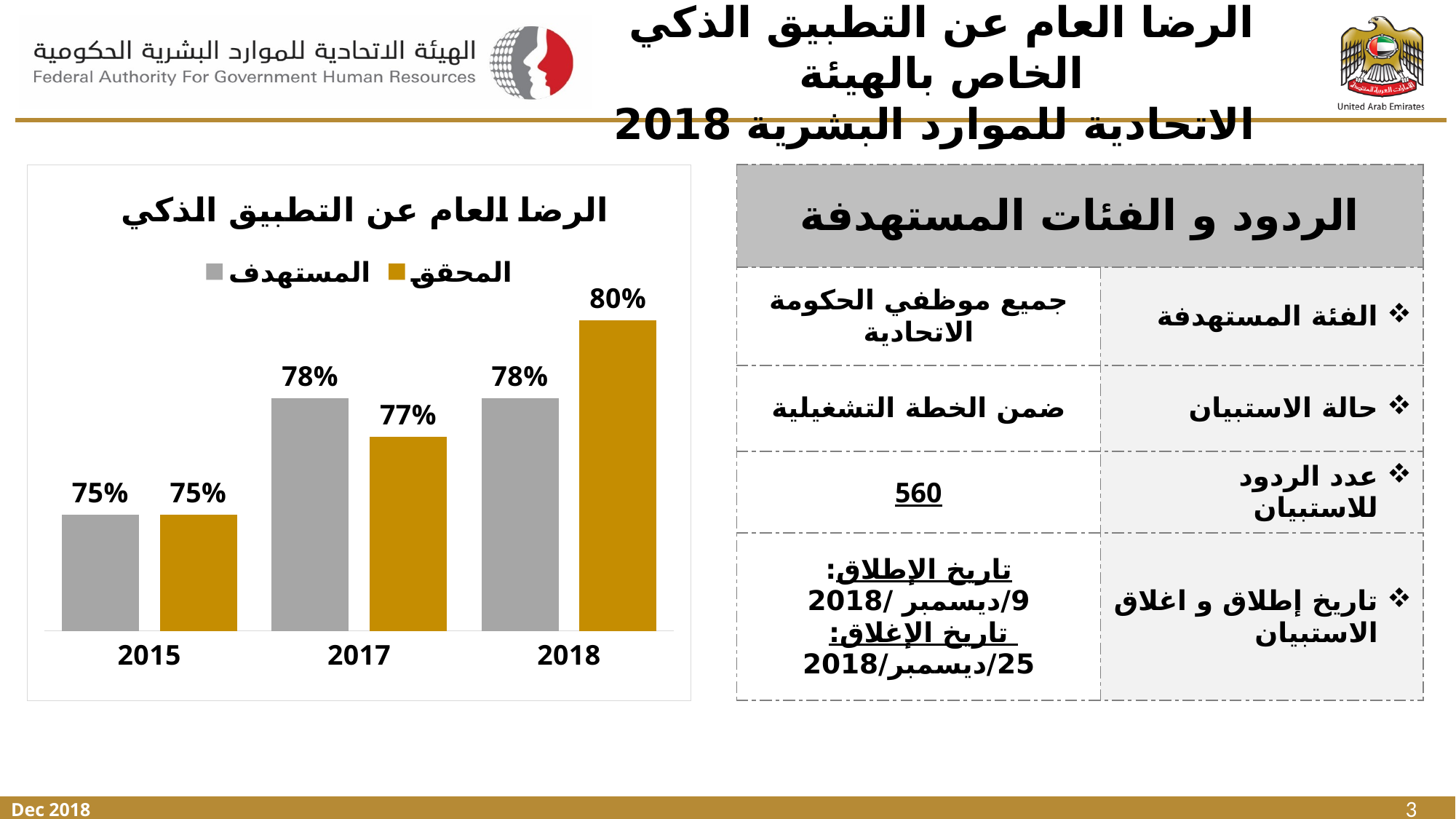
What is the achieved (المحقق) value for 2015? 75% In 2017, which is larger: the target (المستهدف) or the achieved (المحقق) value? المستهدف (target) What is the difference between the achieved and target values in 2018? 2% What is the target (المستهدف) value for 2018? 78% What type of chart is shown on the slide? bar chart How many years are shown on the x axis of the chart? 3 Does the achieved (المحقق) value rise or fall from 2015 to 2018? rise What is the achieved (المحقق) value for 2018? 80% How many series does the chart legend list? 2 Which year has the highest achieved (المحقق) value? 2018 Which year has the lowest target (المستهدف) value? 2015 What is the target (المستهدف) value for 2017? 78%